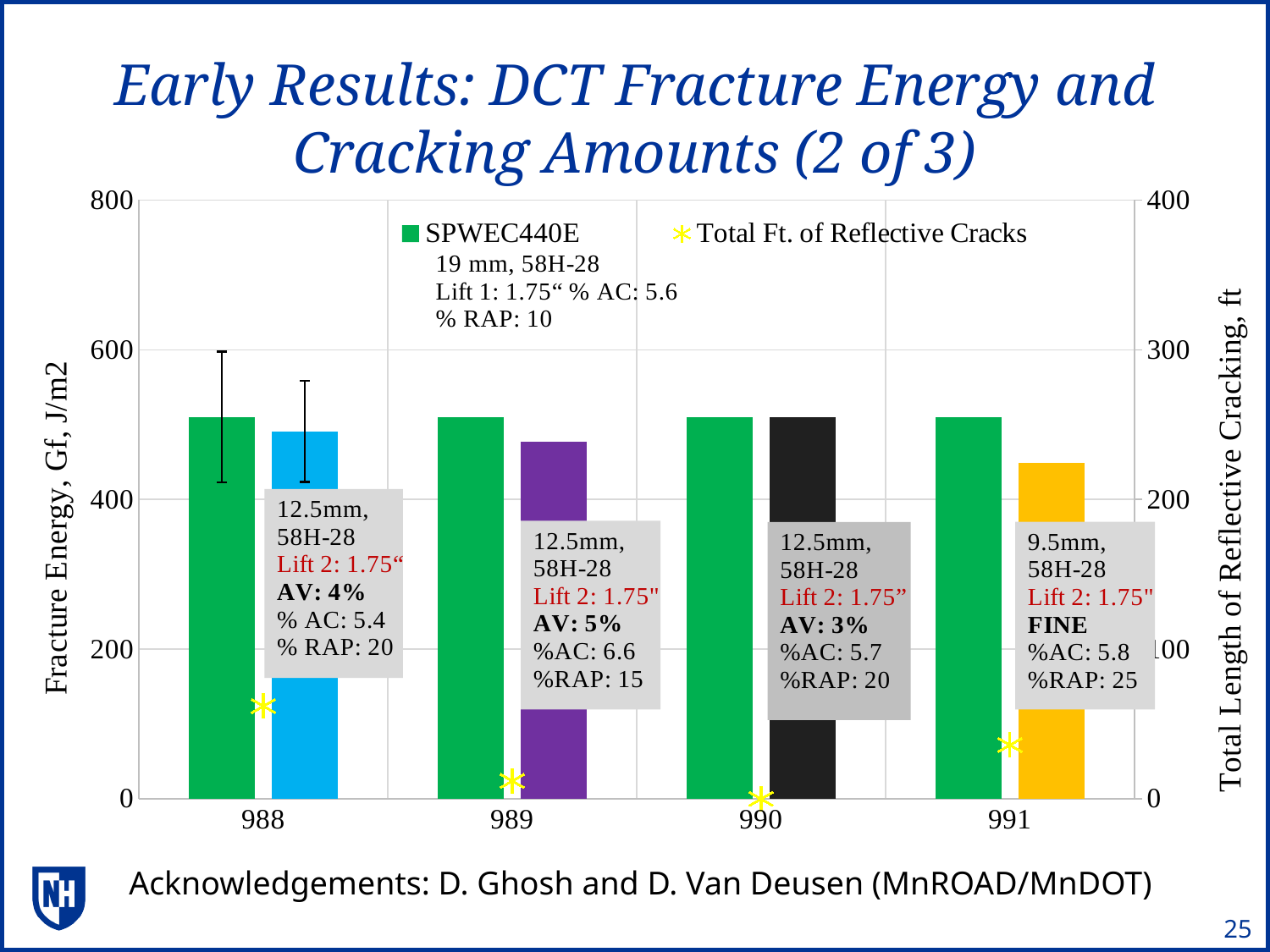
What kind of chart is shown on the slide? bar chart Is the fracture energy of the SPWEC440E (green) bar for 988 greater or less than 400 J/m2? greater Is the fracture energy of the yellow bar for 991 greater or less than 600 J/m2? less Is the fracture energy of the black bar for 990 greater or less than 600 J/m2? less Which section has the highest Total Ft. of Reflective Cracks (yellow star)? 988 How many categories are shown on the x axis of the chart? 4 For 991, which bar has the higher fracture energy, the green SPWEC440E bar or the yellow bar? the green SPWEC440E bar What is the title of the left vertical axis of the chart? Fracture Energy, Gf, J/m2 How many series does the chart legend list? 2 What is the title of the right vertical axis of the chart? Total Length of Reflective Cracking, ft